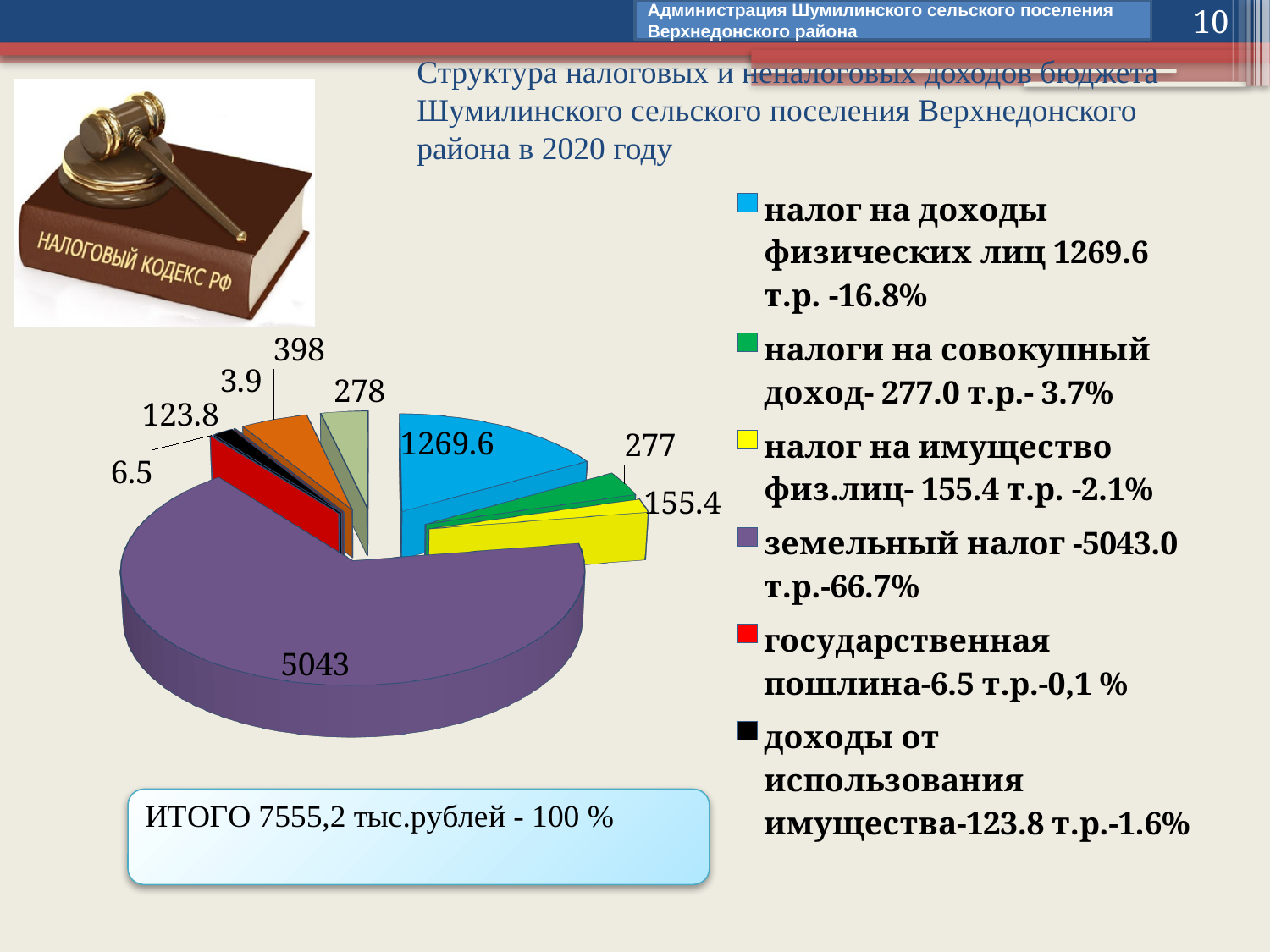
How many entries does the legend list? 6 Which is larger, the slice labelled 398 or the slice labelled 278? 398 What value is labelled on the slice for налог на доходы физических лиц? 1269.6 What value is labelled on the slice for налог на имущество физ.лиц? 155.4 What is the difference between the slice labelled 1269.6 and the slice labelled 277? 992.6 According to the legend, what share of the total does земельный налог represent? 66.7% What value is labelled on the slice for земельный налог? 5043 What value is labelled on the slice for доходы от использования имущества? 123.8 What is the smallest value labelled on the pie chart? 3.9 Which category has the largest slice of the pie? земельный налог How many slices does the pie chart have? 9 What kind of chart is shown on the slide? pie chart